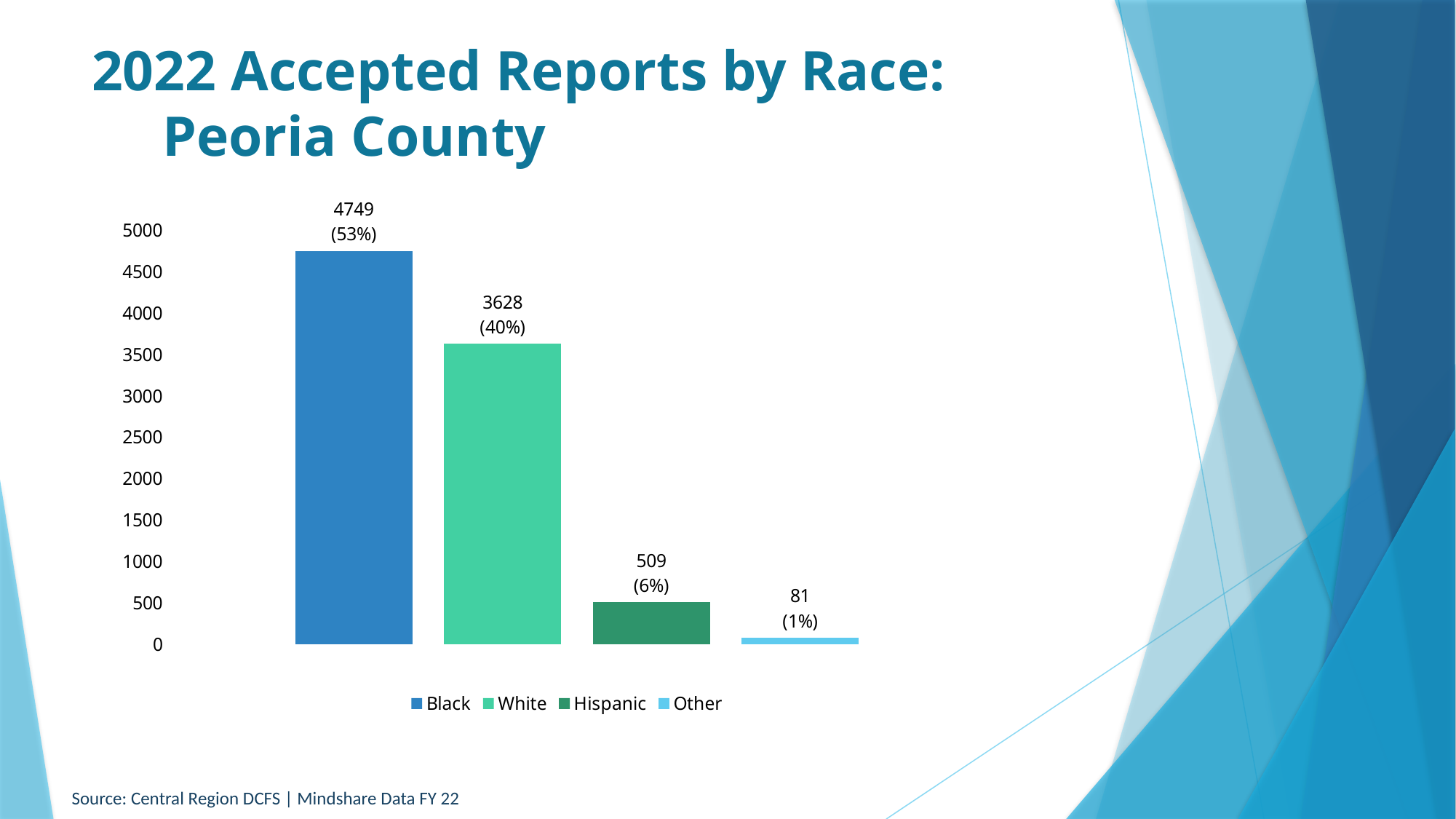
What is the number of accepted reports for Other? 81 Which is larger, the value for Hispanic or the value for Other? Hispanic What percentage of accepted reports is shown for White? 40% What is the title of the slide? 2022 Accepted Reports by Race: Peoria County What is the number of accepted reports for Hispanic? 509 What is the number of accepted reports for Black? 4749 What is the number of accepted reports for White? 3628 What is the difference between the Black and White values? 1121 Which category has the highest number of accepted reports? Black Which category has the lowest number of accepted reports? Other What kind of chart is shown on the slide? Bar chart How many categories does the legend list? 4